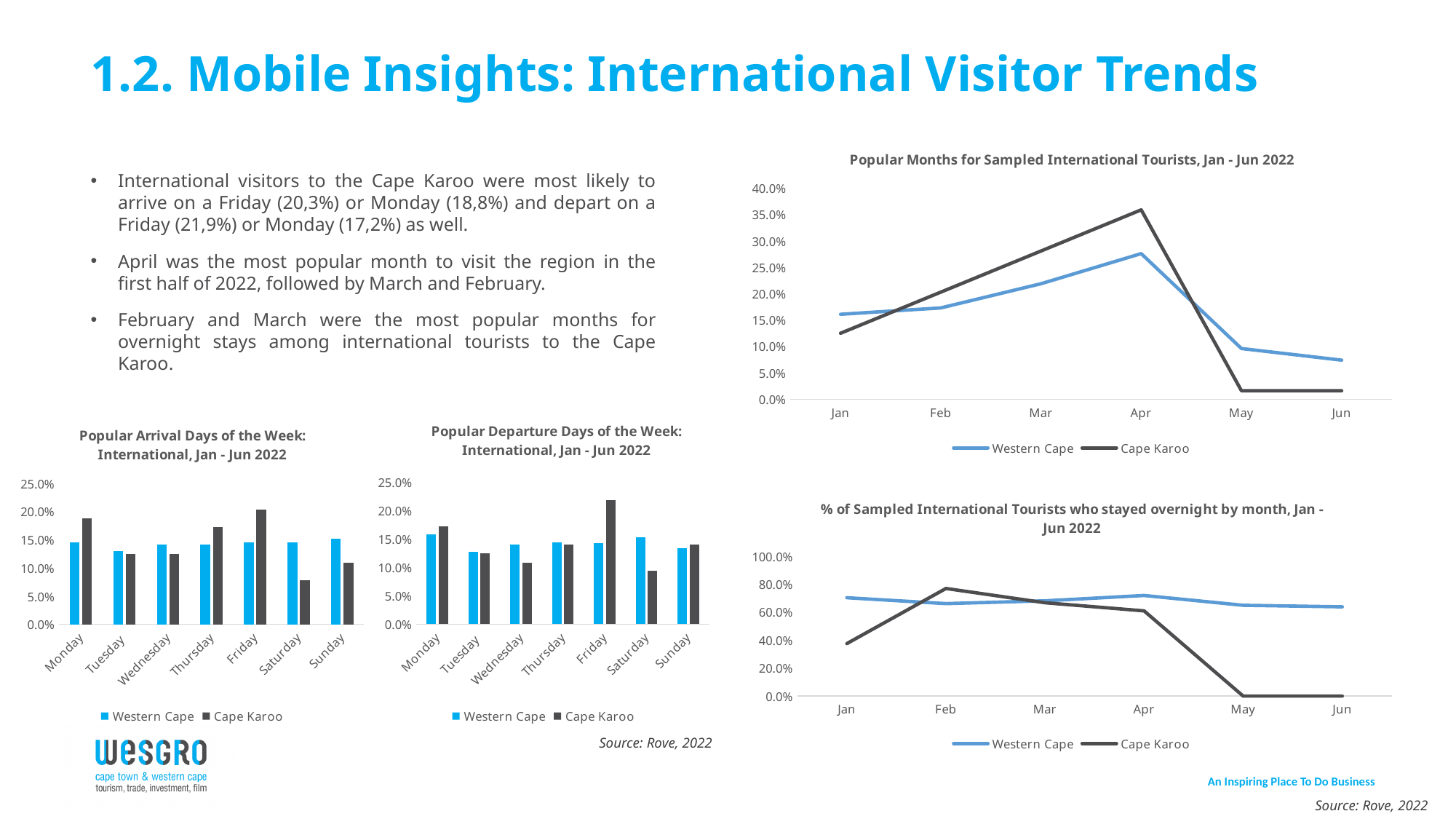
In 'Popular Departure Days of the Week: International, Jan - Jun 2022', which day has the highest value for Cape Karoo? Friday How many months are shown on the x axis of '% of Sampled International Tourists who stayed overnight by month, Jan - Jun 2022'? 6 In 'Popular Months for Sampled International Tourists, Jan - Jun 2022', which month has the highest value for Cape Karoo? Apr In 'Popular Arrival Days of the Week: International, Jan - Jun 2022', which day has the lowest value for Cape Karoo? Saturday How many series does the legend of 'Popular Departure Days of the Week: International, Jan - Jun 2022' list? 2 In 'Popular Months for Sampled International Tourists, Jan - Jun 2022', is the Cape Karoo value for Apr greater or less than 30.0%? greater What kind of chart is 'Popular Months for Sampled International Tourists, Jan - Jun 2022'? line chart What kind of chart is 'Popular Arrival Days of the Week: International, Jan - Jun 2022'? bar chart In '% of Sampled International Tourists who stayed overnight by month, Jan - Jun 2022', does the Cape Karoo line rise or fall from Apr to May? fall In '% of Sampled International Tourists who stayed overnight by month, Jan - Jun 2022', which month has the highest value for Cape Karoo? Feb In 'Popular Arrival Days of the Week: International, Jan - Jun 2022', which is larger on Monday: Western Cape or Cape Karoo? Cape Karoo How many days of the week are shown in 'Popular Arrival Days of the Week: International, Jan - Jun 2022'? 7